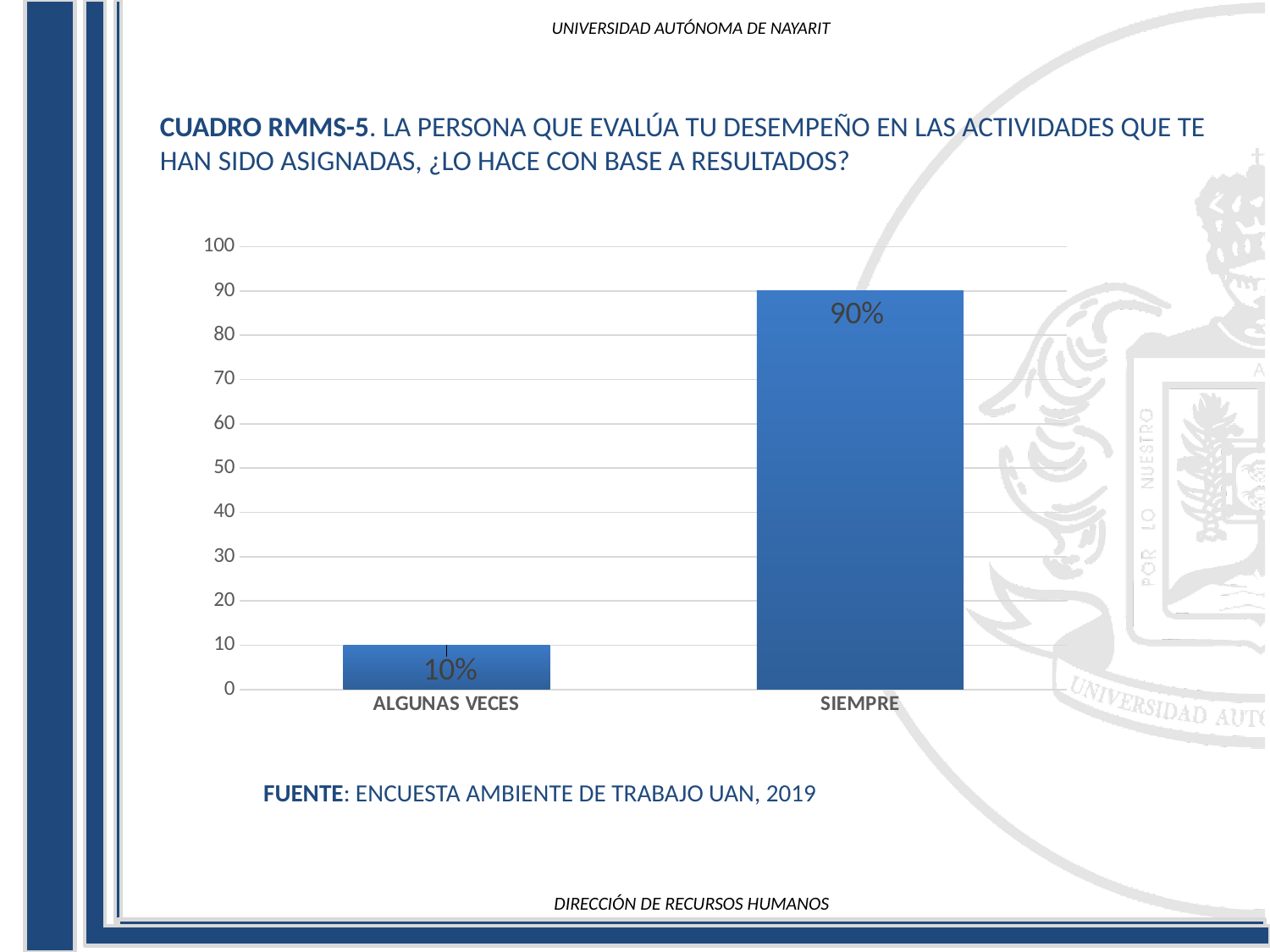
How many categories are shown on the x axis? 2 What is the difference between the values for SIEMPRE and ALGUNAS VECES? 80% Which category has the lowest value? ALGUNAS VECES What source is cited below the chart? ENCUESTA AMBIENTE DE TRABAJO UAN, 2019 Which is larger, the value for ALGUNAS VECES or the value for SIEMPRE? SIEMPRE Is the value for SIEMPRE greater or less than 50? greater Which category has the highest value? SIEMPRE What is the value for SIEMPRE? 90% What is the value for ALGUNAS VECES? 10% Is the value for ALGUNAS VECES greater or less than 20? less What is the maximum value shown on the vertical axis? 100 What kind of chart is shown on the slide? Bar chart